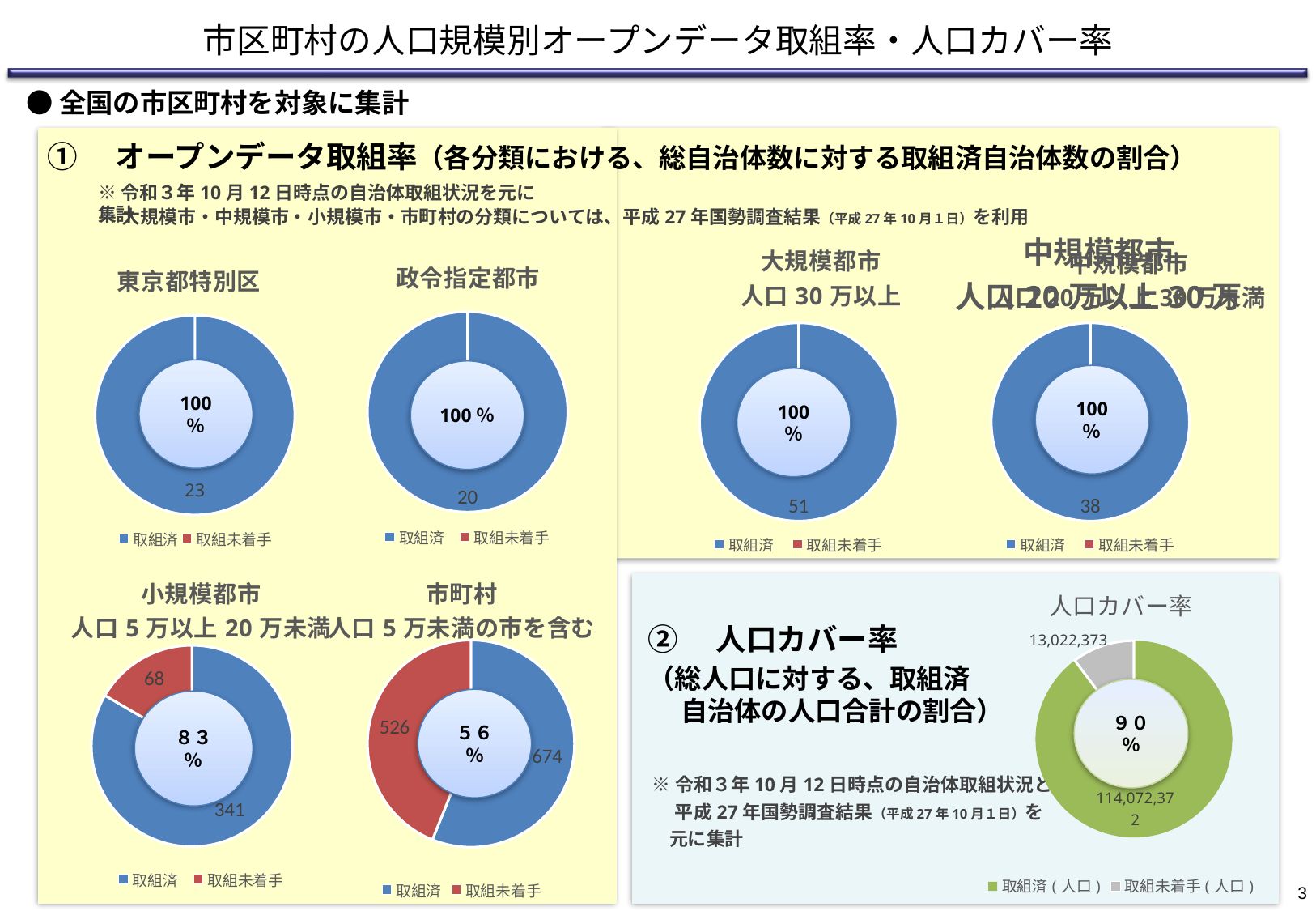
In the 市町村 chart, what percentage is shown in the centre for 取組済? 56% What kind of chart is used for 政令指定都市? Donut (pie) chart In the 市町村 chart, what is the value for 取組未着手? 526 In the 市町村 chart, what is the value for 取組済? 674 In the 市町村 chart, which is larger, 取組済 or 取組未着手? 取組済 How many series does the legend of the 小規模都市 chart list? 2 In the 東京都特別区 chart, what value is shown for 取組済? 23 In the 人口カバー率 chart, what is the value for 取組未着手（人口）? 13,022,373 In the 小規模都市 chart, what is the value for 取組未着手? 68 In the 大規模都市 chart, what value is shown for 取組済? 51 In the 小規模都市 chart, what is the total of 取組済 and 取組未着手? 409 In the 小規模都市 chart, what is the value for 取組済? 341